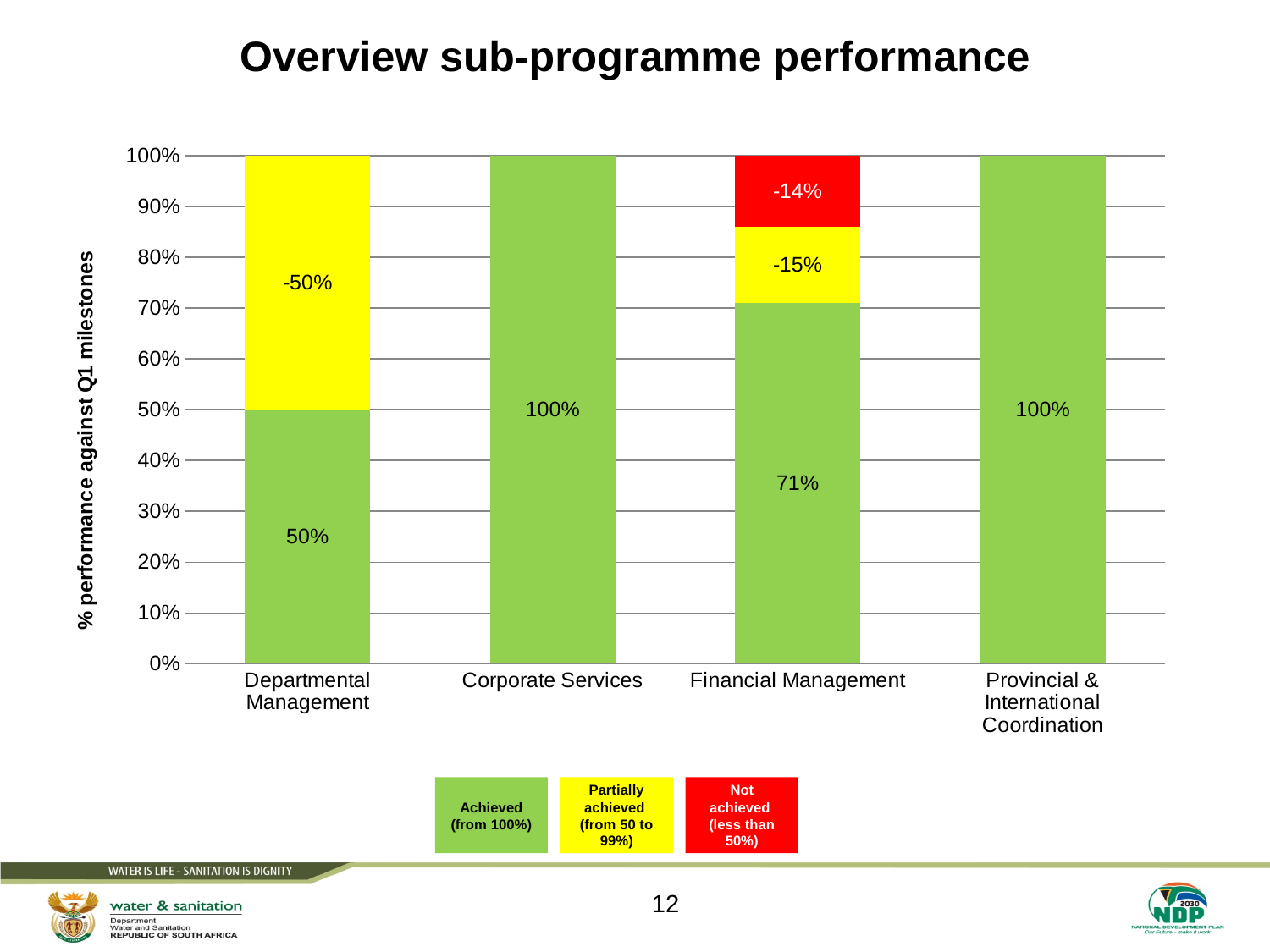
What is the 'Achieved' value for Departmental Management? 50% What is the difference between the 'Achieved' values for Financial Management and Departmental Management? 21% What is the 'Achieved' value for Corporate Services? 100% What type of chart is shown on the slide? Stacked bar chart What label is shown on the red 'Not achieved' segment for Financial Management? -14% Which sub-programme has the lowest 'Achieved' value? Departmental Management Which is larger, the 'Achieved' value for Financial Management or for Departmental Management? Financial Management What is the title of the y axis? % performance against Q1 milestones How many sub-programmes (categories) are shown on the x axis? 4 What is the 'Achieved' value for Financial Management? 71% How many series does the legend list? 3 What label is shown on the yellow 'Partially achieved' segment for Departmental Management? -50%